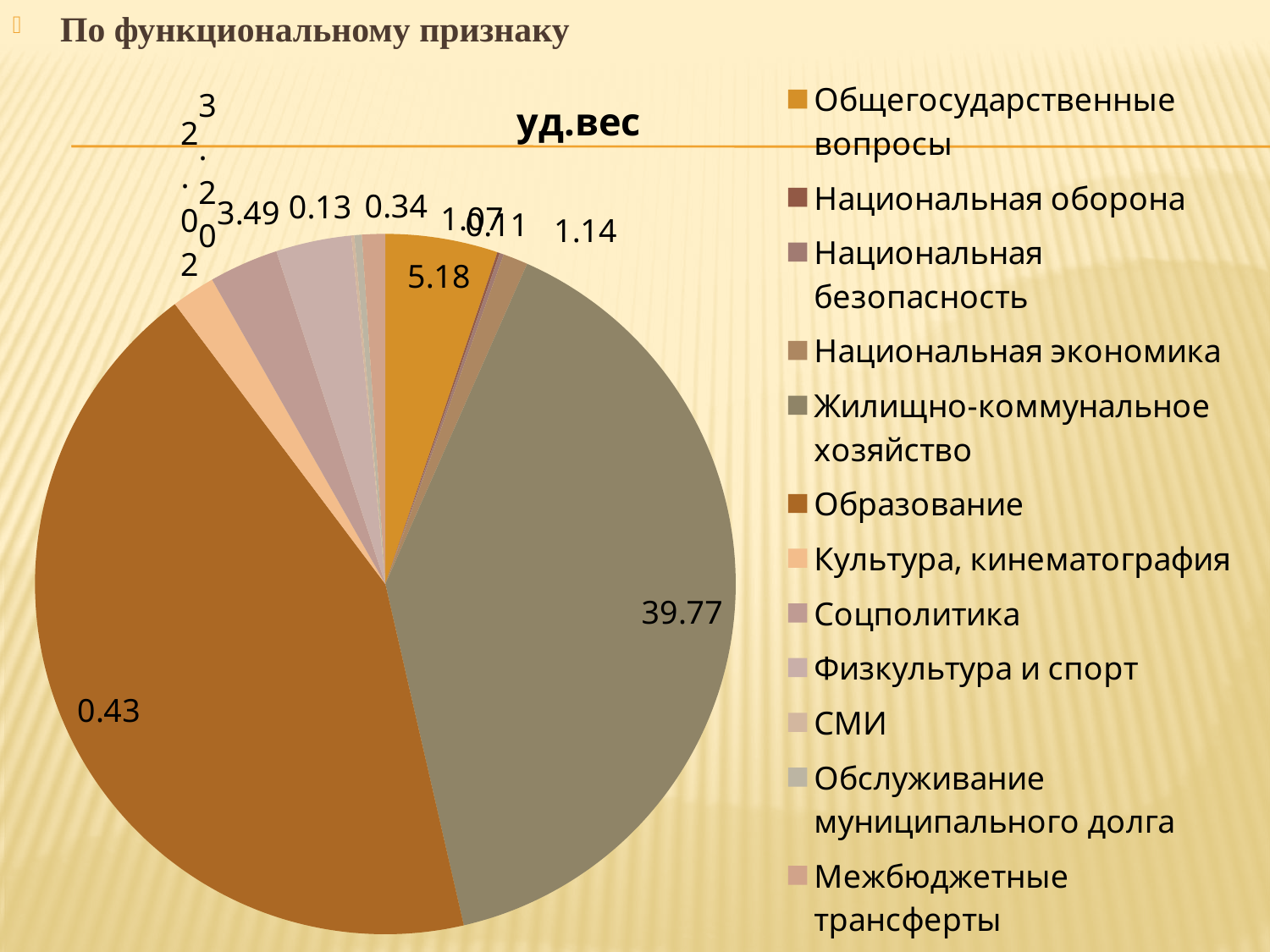
What is the difference between the values for Общегосударственные вопросы and Национальная экономика? 4.04 What value is shown for Национальная экономика? 1.14 What is the difference between the values for Жилищно-коммунальное хозяйство and Общегосударственные вопросы? 34.59 What value is shown for Общегосударственные вопросы? 5.18 What kind of chart is shown on the slide? pie chart What value is shown for Жилищно-коммунальное хозяйство? 39.77 What colour is the slice for Общегосударственные вопросы? orange What is the title of the chart? уд.вес Which is larger, Общегосударственные вопросы or Национальная экономика? Общегосударственные вопросы Which is larger, Жилищно-коммунальное хозяйство or Общегосударственные вопросы? Жилищно-коммунальное хозяйство How many categories does the legend of the chart list? 12